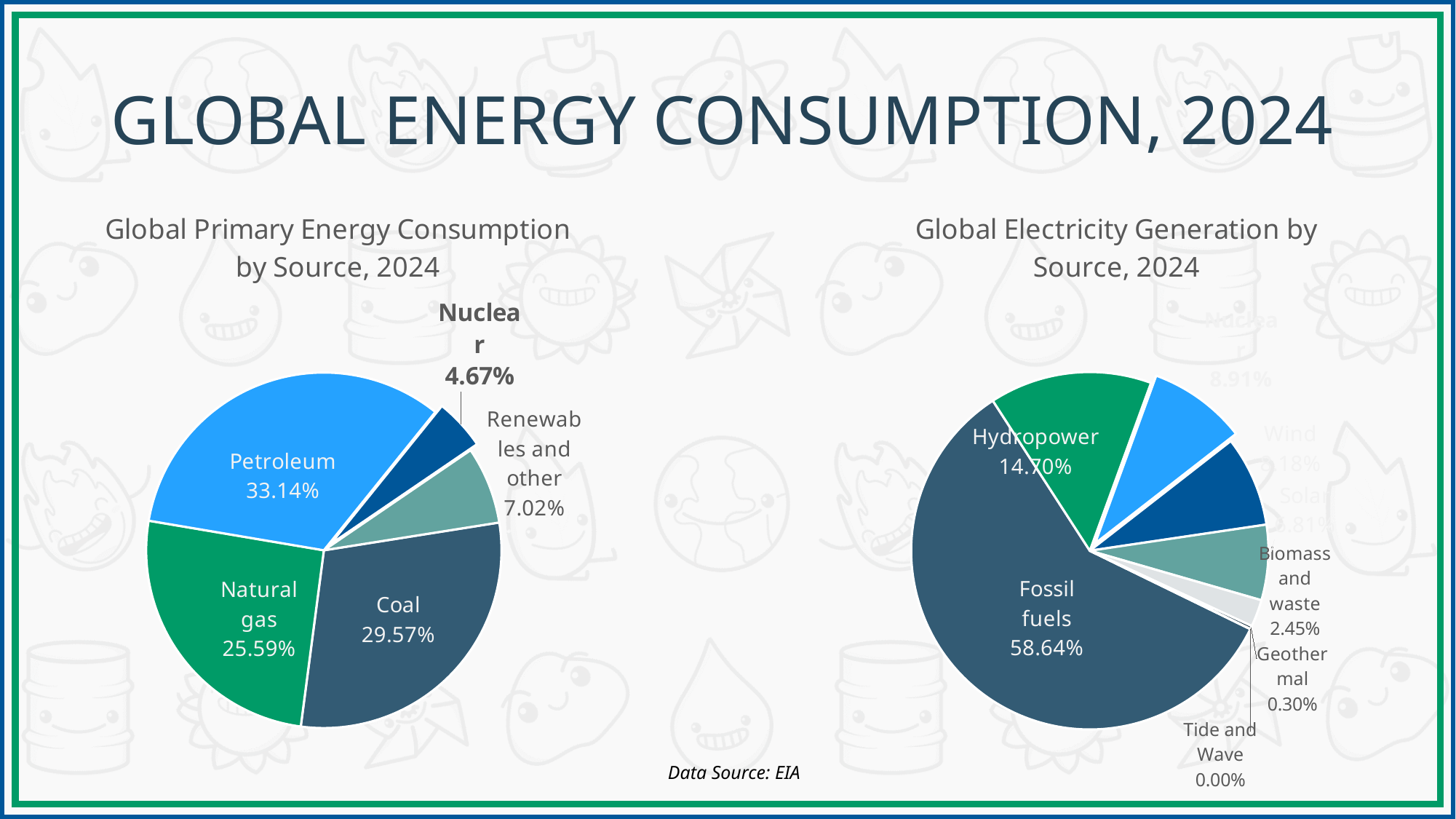
How many slices does the "Global Primary Energy Consumption by Source, 2024" pie chart have? 5 In the "Global Primary Energy Consumption by Source, 2024" chart, what share does Petroleum have? 33.14% In the "Global Primary Energy Consumption by Source, 2024" chart, how many percentage points larger is Petroleum than Coal? 3.57% In the "Global Electricity Generation by Source, 2024" chart, what share does Biomass and waste have? 2.45% In the "Global Primary Energy Consumption by Source, 2024" chart, which source has the smallest slice? Nuclear In the "Global Primary Energy Consumption by Source, 2024" chart, which is larger, Natural gas or Coal? Coal In the "Global Electricity Generation by Source, 2024" chart, what share do Fossil fuels have? 58.64% In the "Global Primary Energy Consumption by Source, 2024" chart, what share does Coal have? 29.57% In the "Global Electricity Generation by Source, 2024" chart, how many percentage points larger are Fossil fuels than Hydropower? 43.94% In the "Global Electricity Generation by Source, 2024" chart, what share does Hydropower have? 14.70% What kind of chart is the "Global Primary Energy Consumption by Source, 2024" chart on the left? Pie chart In the "Global Primary Energy Consumption by Source, 2024" chart, which source has the largest slice? Petroleum